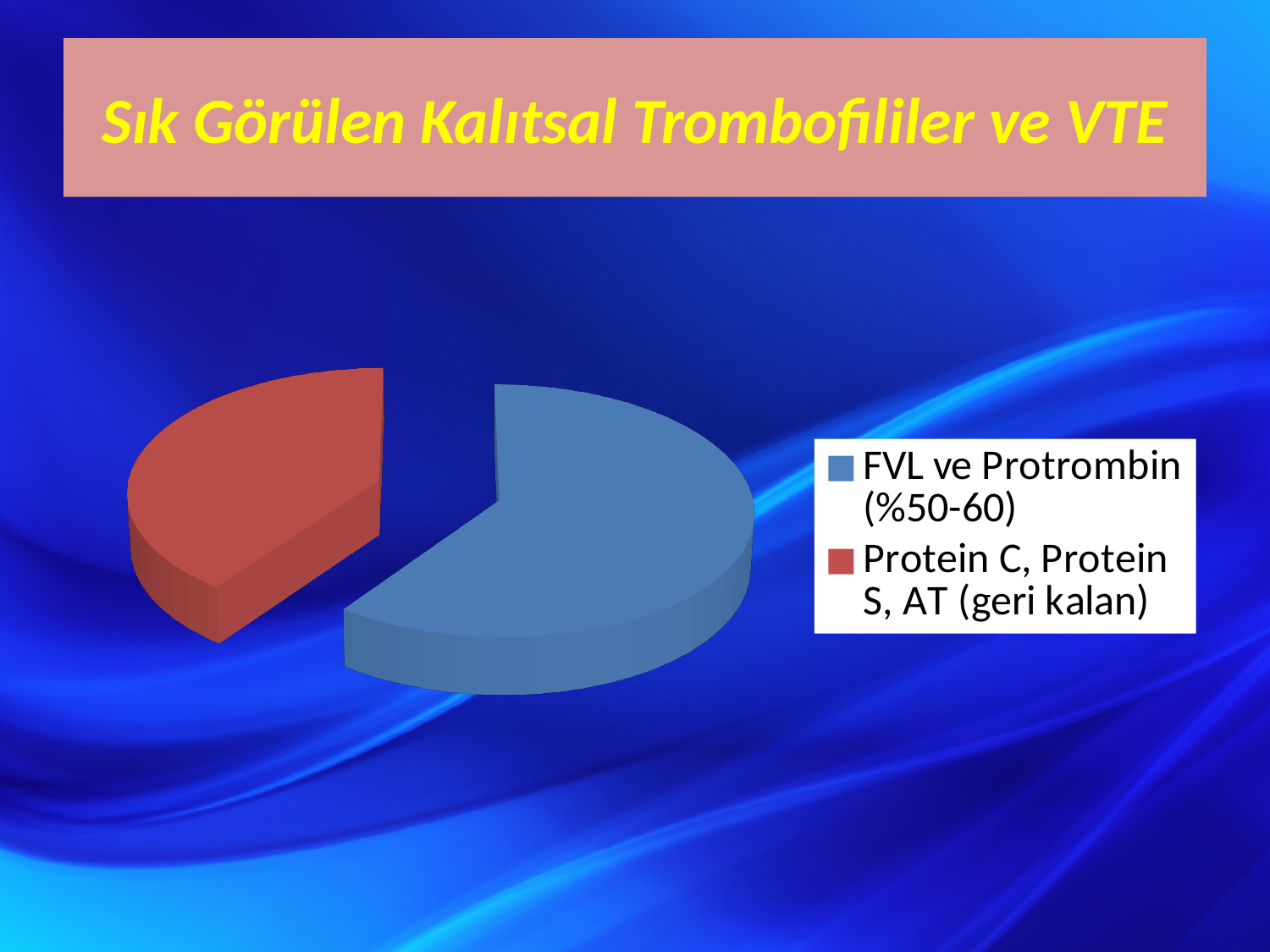
What kind of chart is shown on the slide? pie chart Which slice of the pie chart is the smallest? Protein C, Protein S, AT (geri kalan) Which slice of the pie chart is the largest? FVL ve Protrombin (%50-60) What is the title of the slide containing the pie chart? Sık Görülen Kalıtsal Trombofililer ve VTE Which is larger in the pie chart: the slice for FVL ve Protrombin or the slice for Protein C, Protein S, AT? FVL ve Protrombin How many entries does the legend of the pie chart list? 2 What colour is the slice for Protein C, Protein S, AT (geri kalan) in the pie chart? red How many slices does the pie chart have? 2